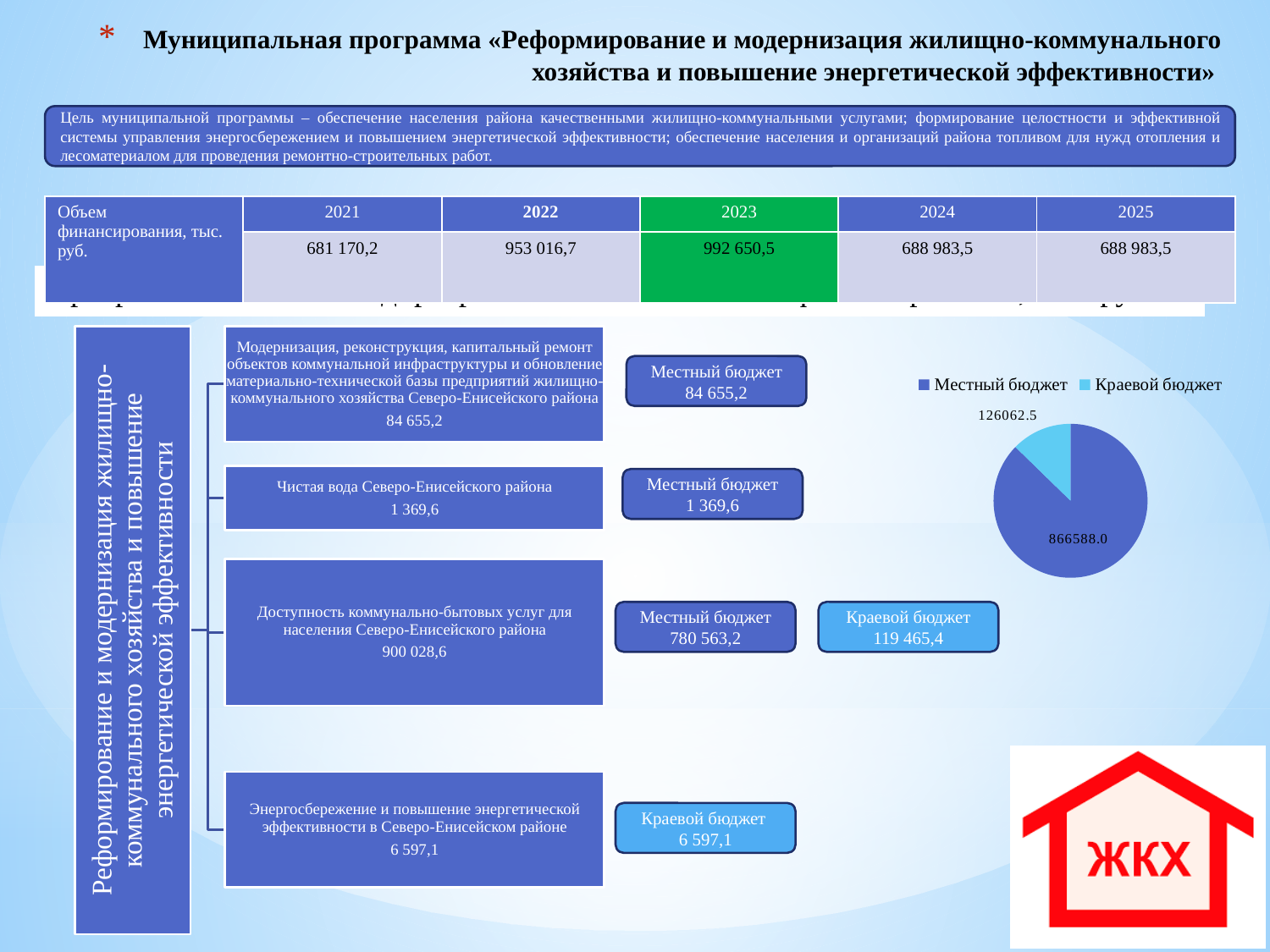
In the pie chart, which slice is the largest? Местный бюджет In the pie chart, what is the value for Местный бюджет? 866588.0 In the pie chart, what share of the total does Местный бюджет represent? 87.3% In the pie chart, what is the difference between the Местный бюджет and Краевой бюджет values? 740525.5 How many slices does the pie chart have? 2 In the pie chart, what is the value for Краевой бюджет? 126062.5 In the pie chart, which is larger: Местный бюджет or Краевой бюджет? Местный бюджет How many entries does the legend of the pie chart list? 2 What kind of chart is shown on the right side of the slide? pie chart In the pie chart, what is the total of the two slices? 992650.5 In the pie chart, what colour is the Краевой бюджет slice? light blue In the pie chart, which slice is the smallest? Краевой бюджет